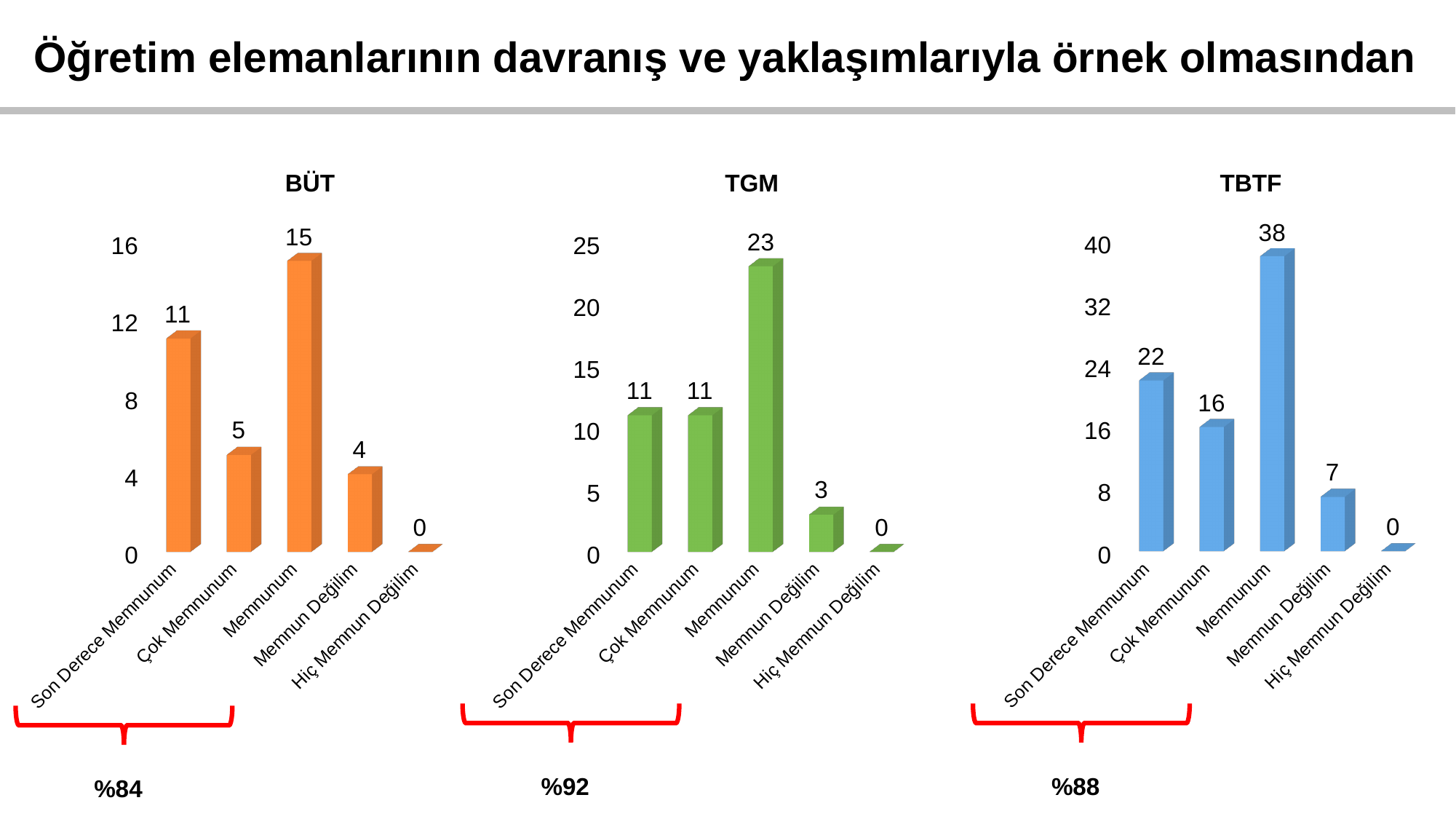
In the TGM chart, is the value for Memnunum greater or less than 20? greater In the TBTF chart, what is the difference between the values for Son Derece Memnunum and Memnun Değilim? 15 In the TGM chart, what is the value for Memnun Değilim? 3 In the TBTF chart, what is the value for Çok Memnunum? 16 What percentage is shown below the bracket under the TGM chart? %92 How many categories are shown in the TBTF chart? 5 In the BÜT chart, which is larger: the value for Son Derece Memnunum or the value for Çok Memnunum? Son Derece Memnunum In the TBTF chart, which category has the highest value? Memnunum In the BÜT chart, which category has the lowest value? Hiç Memnun Değilim In the BÜT chart, what is the value for Memnunum? 15 In the TGM chart, what is the difference between the values for Memnunum and Çok Memnunum? 12 What kind of chart is the TGM chart? bar chart